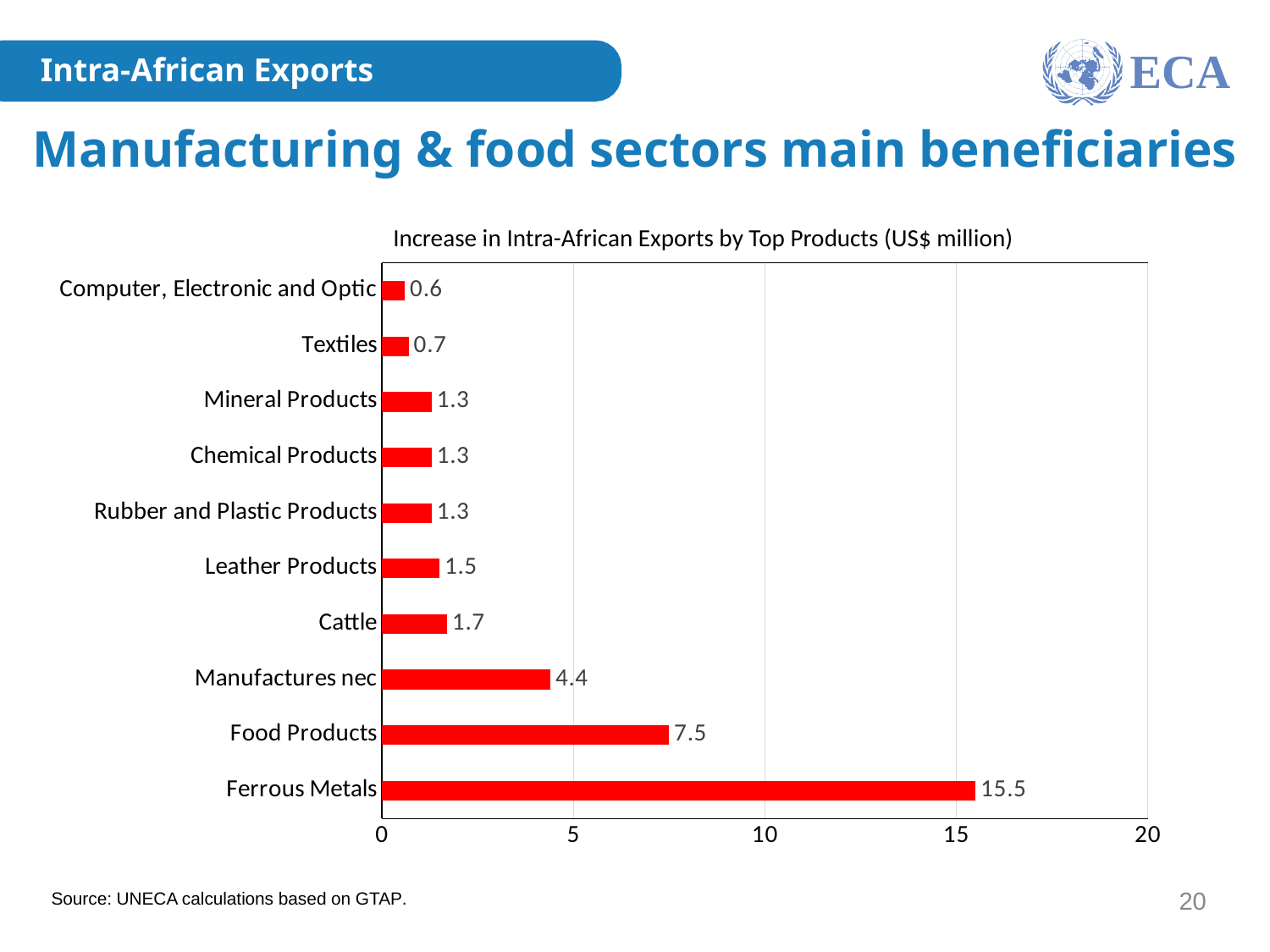
What is the value for Food Products? 7.5 Is the value for Ferrous Metals greater or less than 15? greater What is the title of the chart? Increase in Intra-African Exports by Top Products (US$ million) Which product has the lowest value? Computer, Electronic and Optic What is the value for Cattle? 1.7 What is the value for Ferrous Metals? 15.5 What is the difference between the values for Manufactures nec and Leather Products? 2.9 Which product has the highest value? Ferrous Metals What kind of chart is shown on the slide? bar chart What is the difference between the values for Ferrous Metals and Food Products? 8.0 How many products are shown in the chart? 10 Which is larger, the value for Food Products or the value for Manufactures nec? Food Products